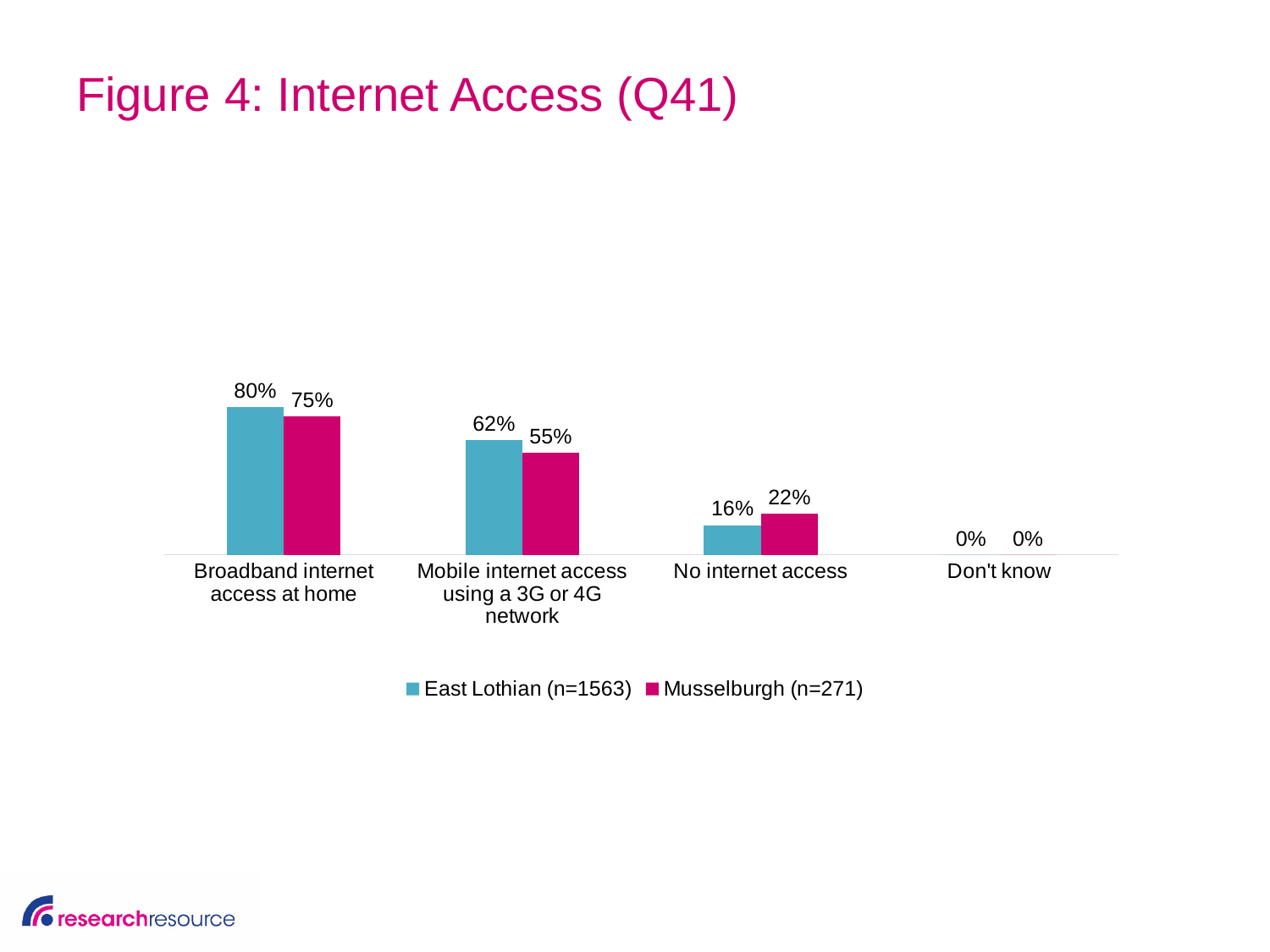
What is the difference between Musselburgh and East Lothian for 'No internet access'? 6% How many series does the legend list? 2 What kind of chart is shown on the slide? Bar chart What is the value for Musselburgh for 'No internet access'? 22% What is the sample size (n) for Musselburgh shown in the legend? 271 How many categories are shown on the x axis? 4 What is the difference between East Lothian and Musselburgh for broadband internet access at home? 5% What percentage of East Lothian respondents have broadband internet access at home? 80% Which category has the lowest value for Musselburgh? Don't know What percentage of Musselburgh respondents have mobile internet access using a 3G or 4G network? 55% Which category has the highest value for East Lothian? Broadband internet access at home For 'No internet access', which is larger: East Lothian or Musselburgh? Musselburgh